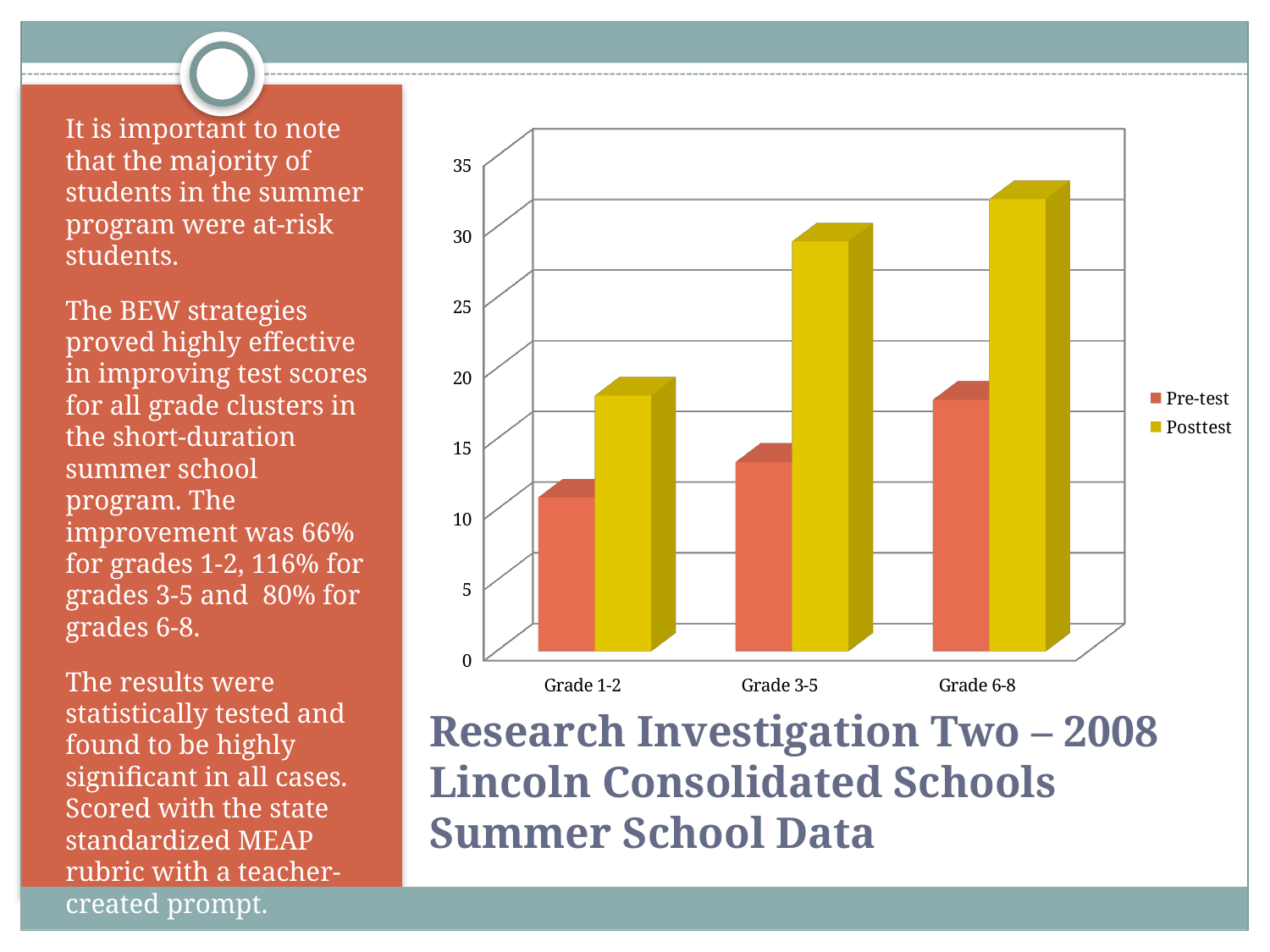
Is the Posttest value for Grade 3-5 greater or less than 25? greater How many series does the chart's legend list? 2 Is the Pre-test value for Grade 6-8 greater or less than 20? less Do the Pre-test values rise or fall from Grade 1-2 to Grade 6-8? rise Which grade cluster has the highest Posttest value? Grade 6-8 Which is larger, the Posttest value for Grade 3-5 or the Posttest value for Grade 1-2? Grade 3-5 How many grade clusters are shown on the x axis of the chart? 3 Is the Pre-test value for Grade 1-2 greater or less than 15? less What are the two series named in the chart's legend? Pre-test and Posttest Which grade cluster has the lowest Pre-test value? Grade 1-2 What kind of chart is shown on the slide? bar chart